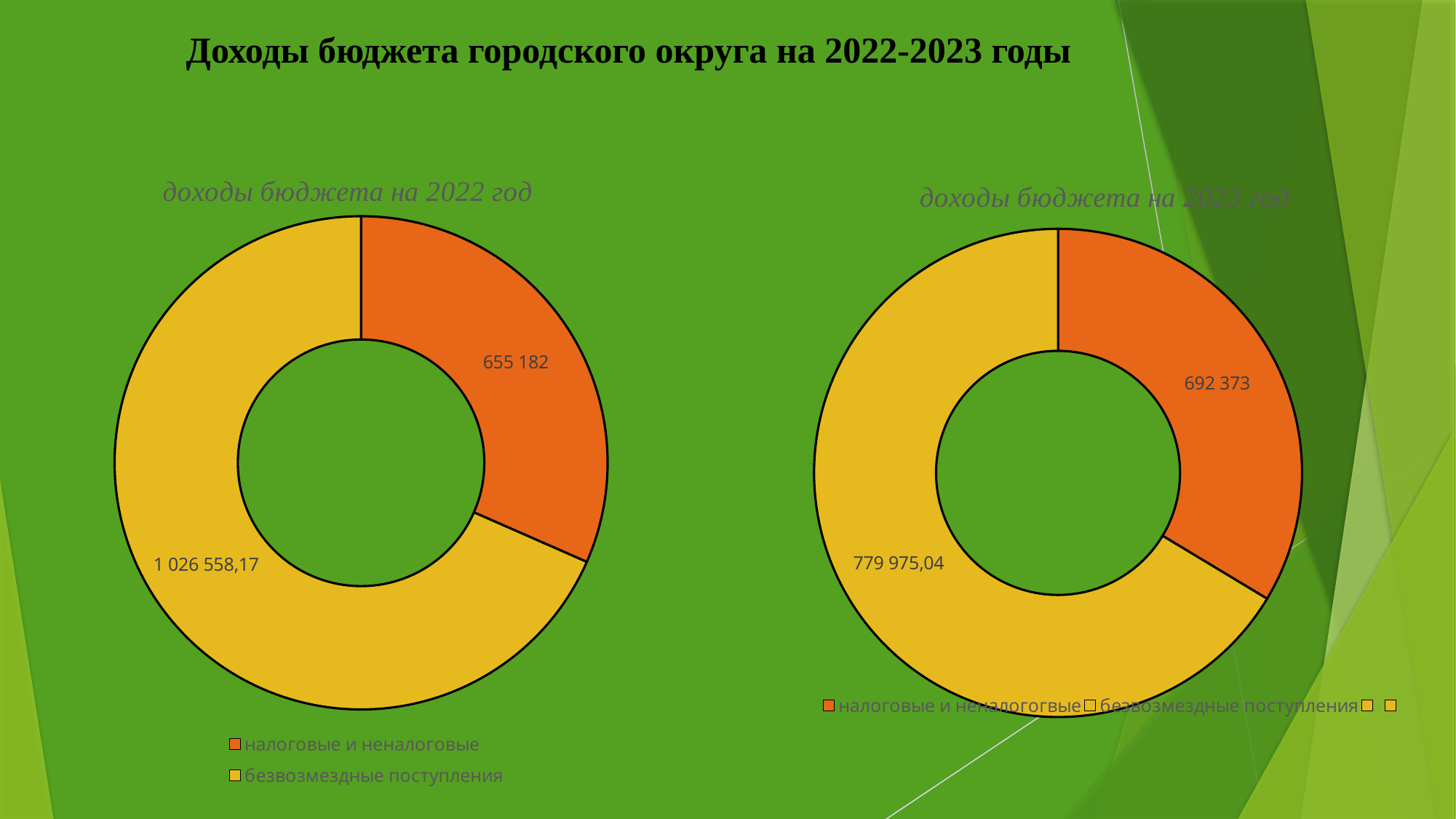
On the chart titled 'доходы бюджета на 2022 год', which category has the largest slice? безвозмездные поступления On the chart titled 'доходы бюджета на 2023 год', what is the value for 'налоговые и неналоговые'? 692 373 On the chart titled 'доходы бюджета на 2022 год', what is the difference between 'безвозмездные поступления' and 'налоговые и неналоговые'? 371 376,17 On the chart titled 'доходы бюджета на 2023 год', what is the difference between 'безвозмездные поступления' and 'налоговые и неналоговые'? 87 602,04 On the chart titled 'доходы бюджета на 2023 год', what is the value for 'безвозмездные поступления'? 779 975,04 What kind of chart is the chart titled 'доходы бюджета на 2023 год'? doughnut chart On the chart titled 'доходы бюджета на 2022 год', what is the value for 'налоговые и неналоговые'? 655 182 On the chart titled 'доходы бюджета на 2022 год', what is the total of the two slices? 1 681 740,17 On the chart titled 'доходы бюджета на 2022 год', what is the value for 'безвозмездные поступления'? 1 026 558,17 On the chart titled 'доходы бюджета на 2023 год', which category has the smallest slice? налоговые и неналогогвые How many slices does the chart titled 'доходы бюджета на 2022 год' have? 2 Which is larger: 'налоговые и неналоговые' on the 2022 chart or 'налоговые и неналоговые' on the 2023 chart? 2023 chart